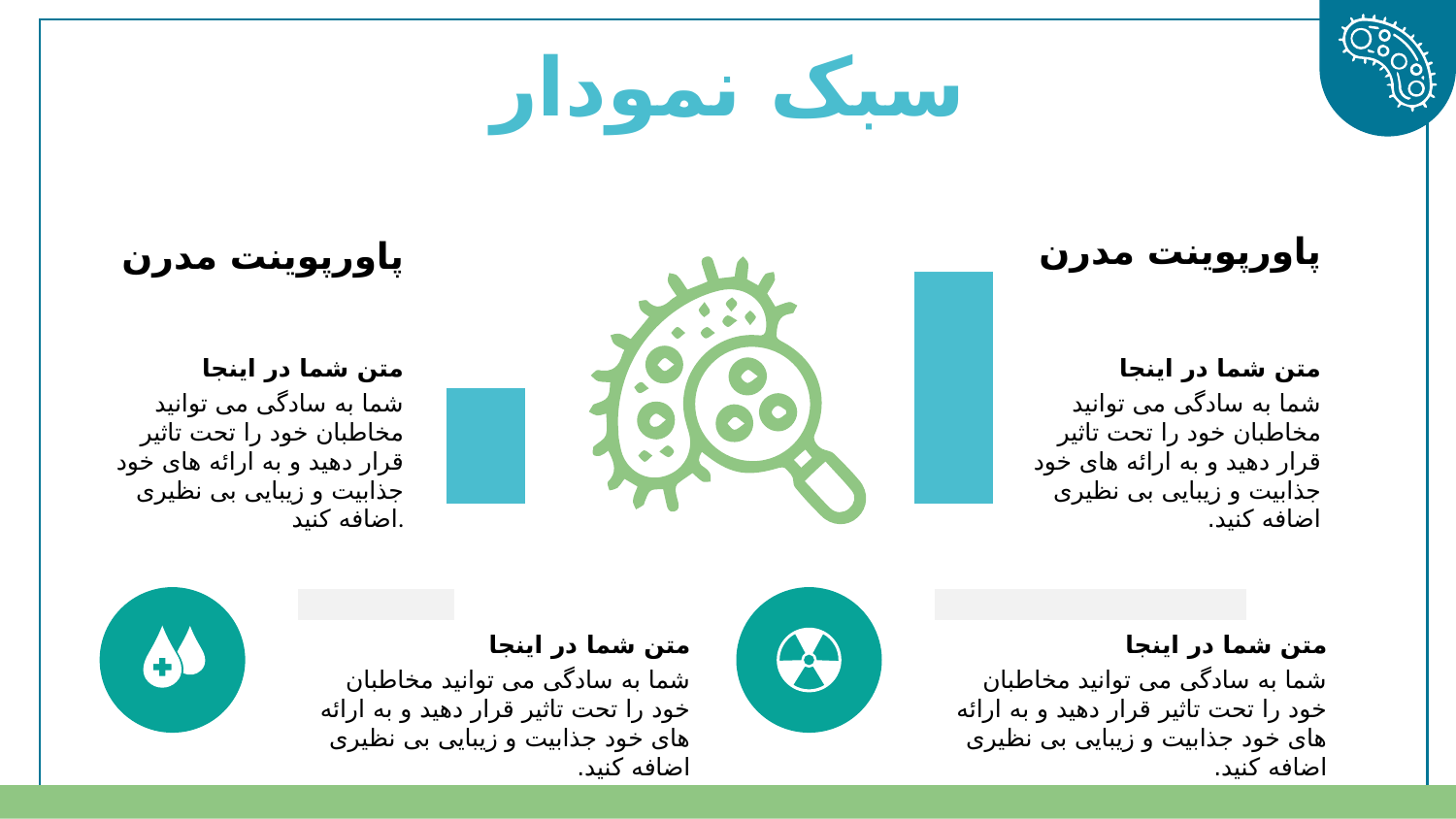
How many bars does the chart on the slide contain? 2 Which bar is taller, the one on the right side of the slide or the one on the left side? the one on the right What kind of chart is shown on the slide? bar chart What colour are the bars in the chart? light blue Which bar is the shortest in the chart? the bar on the left Does the chart show any axis labels or data values? no